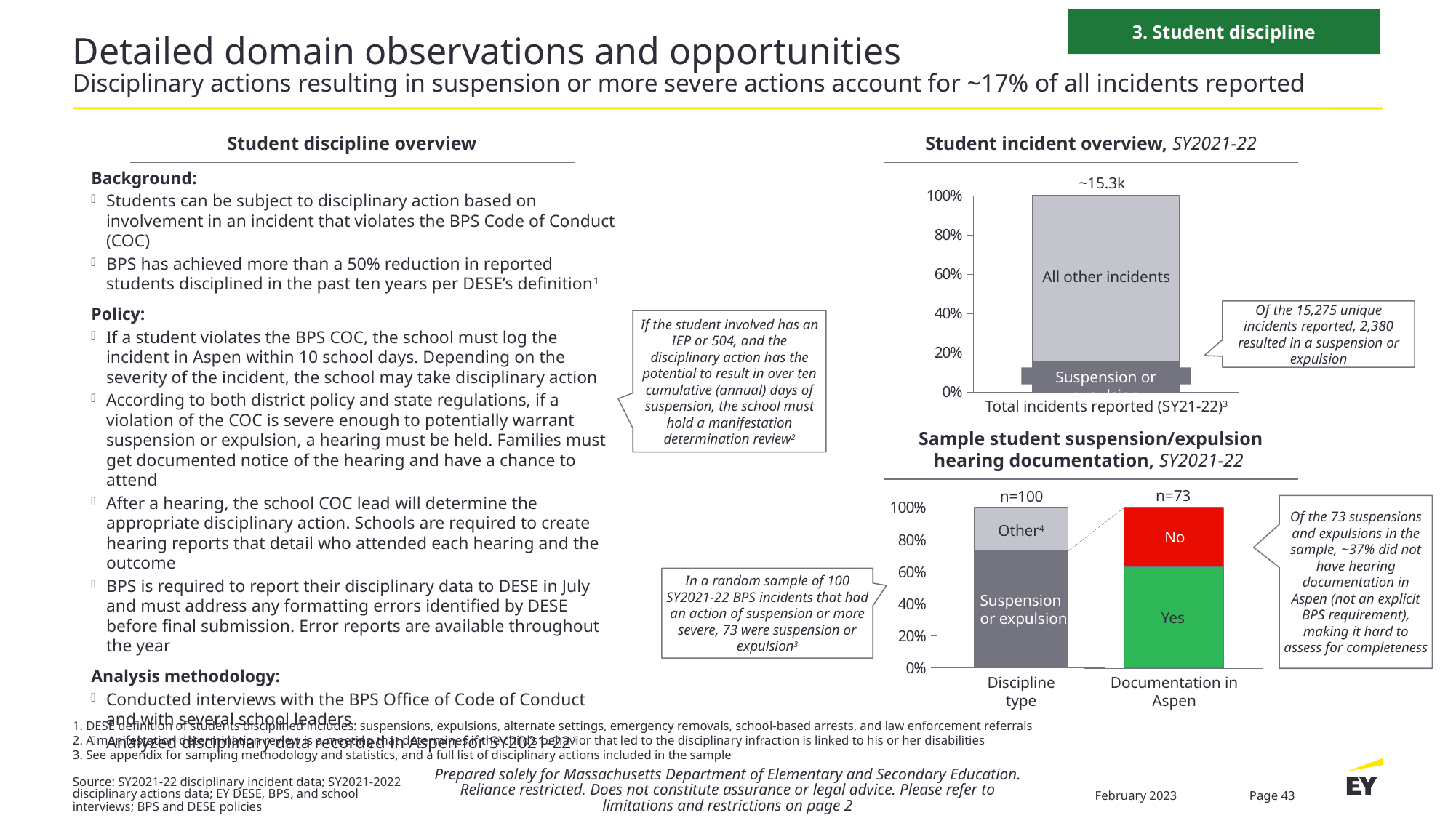
In the 'Sample student suspension/expulsion hearing documentation, SY2021-22' chart, which segment of the 'Documentation in Aspen' bar is larger: 'Yes' or 'No'? Yes In the 'Sample student suspension/expulsion hearing documentation, SY2021-22' chart, is the 'Suspension or expulsion' segment of the 'Discipline type' bar greater or less than 60%? greater How many bars are shown in the 'Sample student suspension/expulsion hearing documentation, SY2021-22' chart? 2 What kind of chart is the 'Sample student suspension/expulsion hearing documentation, SY2021-22' chart? bar chart In the 'Student incident overview, SY2021-22' chart, is the 'Suspension or expulsion' segment greater or less than 20%? less In the 'Student incident overview, SY2021-22' chart, what value is printed above the bar? ~15.3k In the 'Sample student suspension/expulsion hearing documentation, SY2021-22' chart, what is the n value printed above the 'Documentation in Aspen' bar? n=73 What kind of chart is the 'Student incident overview, SY2021-22' chart? bar chart In the 'Student incident overview, SY2021-22' chart, what is the label on the x axis under the bar? Total incidents reported (SY21-22) In the 'Sample student suspension/expulsion hearing documentation, SY2021-22' chart, what is the n value printed above the 'Discipline type' bar? n=100 In the 'Student incident overview, SY2021-22' chart, which segment is larger: 'All other incidents' or 'Suspension or expulsion'? All other incidents In the 'Student incident overview, SY2021-22' chart, is the 'All other incidents' segment greater or less than 80%? greater